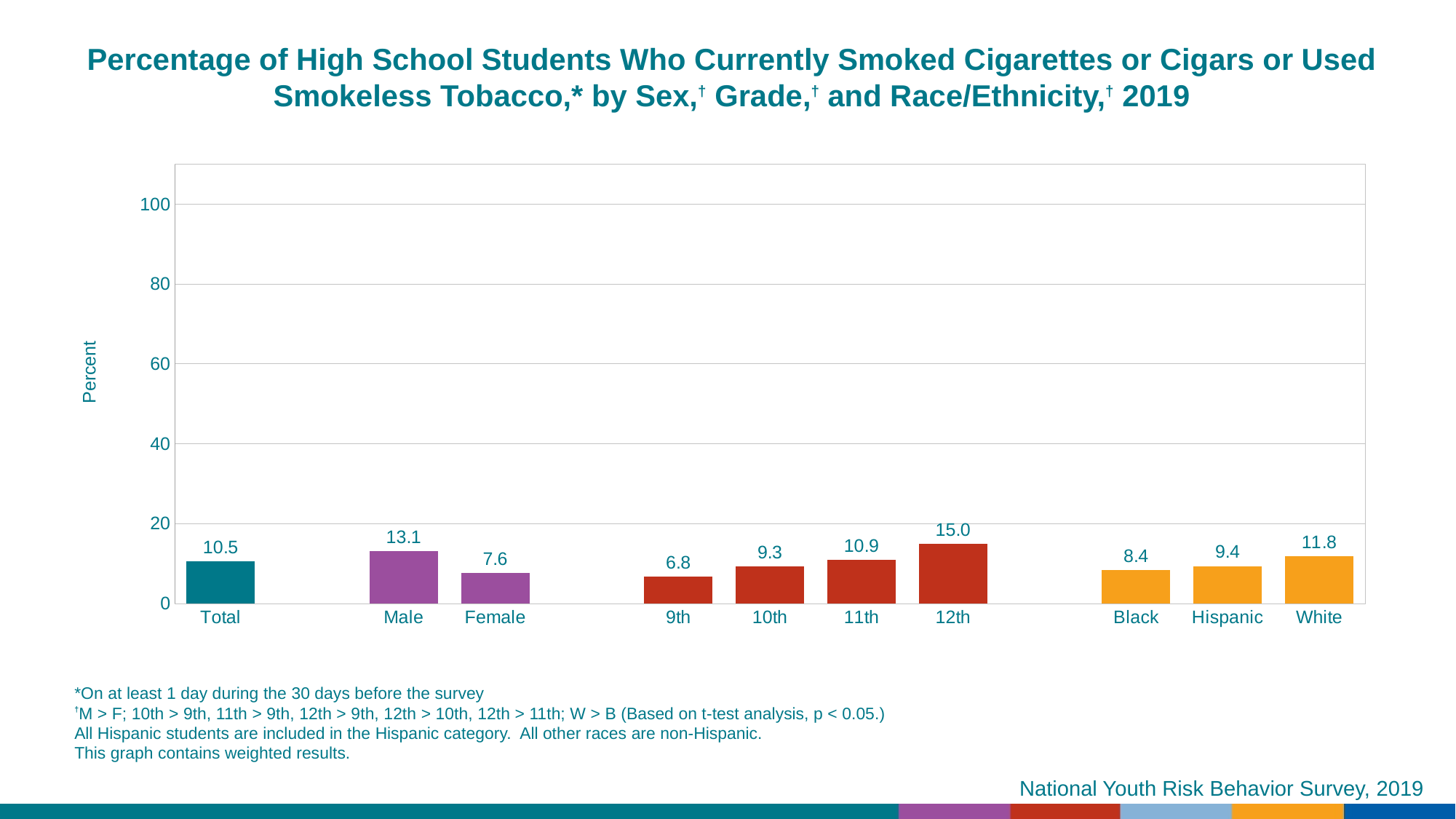
What is the difference between the Male and Female values? 5.5 Which category has the highest value? 12th Do the values rise or fall from 9th grade to 12th grade? rise How many categories are plotted on the chart? 10 What is the value for Female? 7.6 What is the label on the y axis? Percent What is the value for 12th grade? 15.0 Is the value for 11th grade greater or less than 20? less What kind of chart is shown? bar chart Which is larger, the value for White or the value for Black? White What is the value for Total? 10.5 Which category has the lowest value? 9th